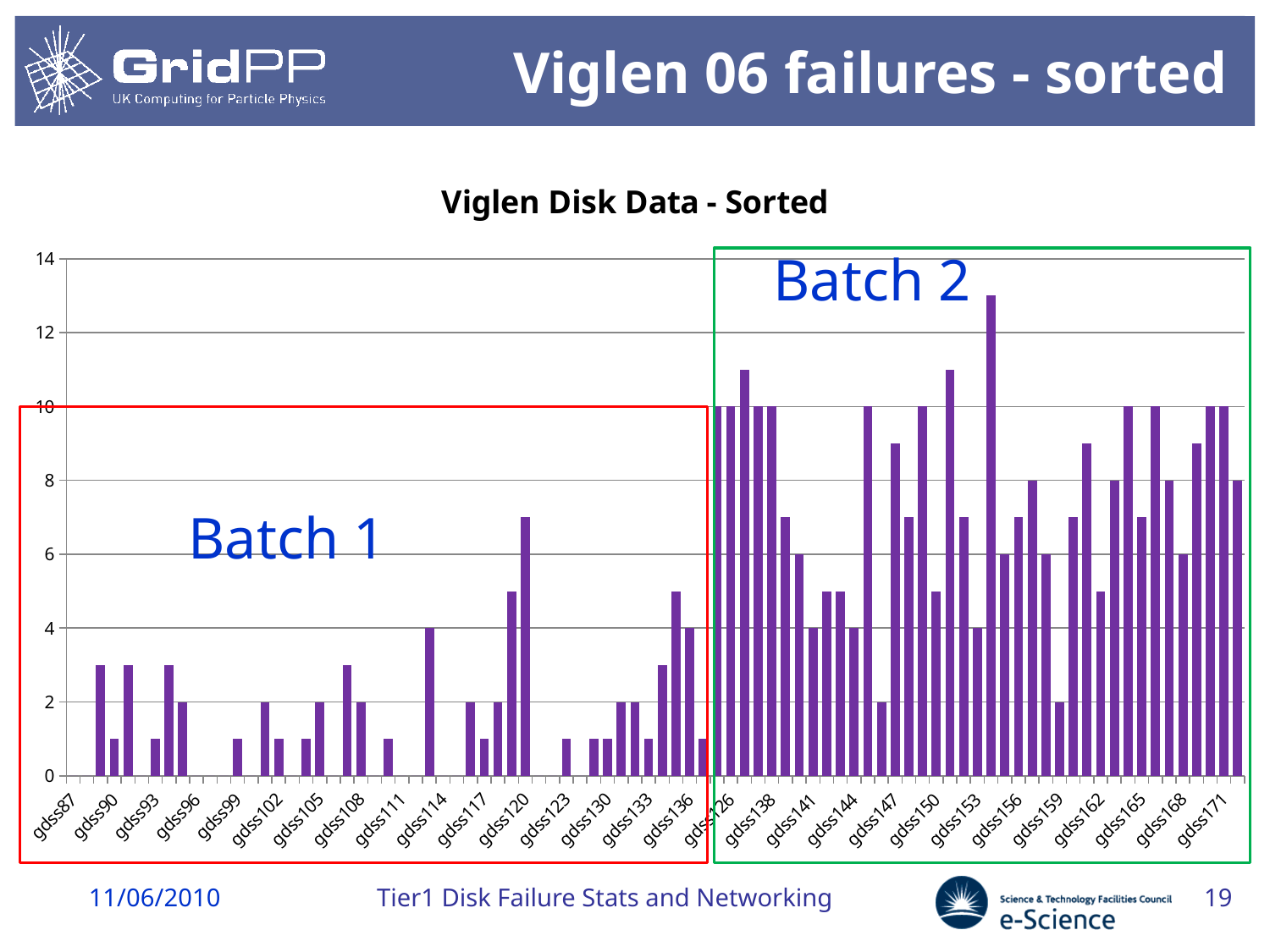
Is the value for gdss147 greater or less than 6? greater Is the value for gdss138 greater or less than 6? greater Is the value for gdss165 greater or less than 4? greater Which has the larger value, gdss138 or gdss90? gdss138 Is the tallest bar on the chart in Batch 1 or Batch 2? Batch 2 What are the two labelled groups of bars on the chart called? Batch 1 and Batch 2 What kind of chart is shown on the slide? bar chart What is the title of the chart? Viglen Disk Data - Sorted